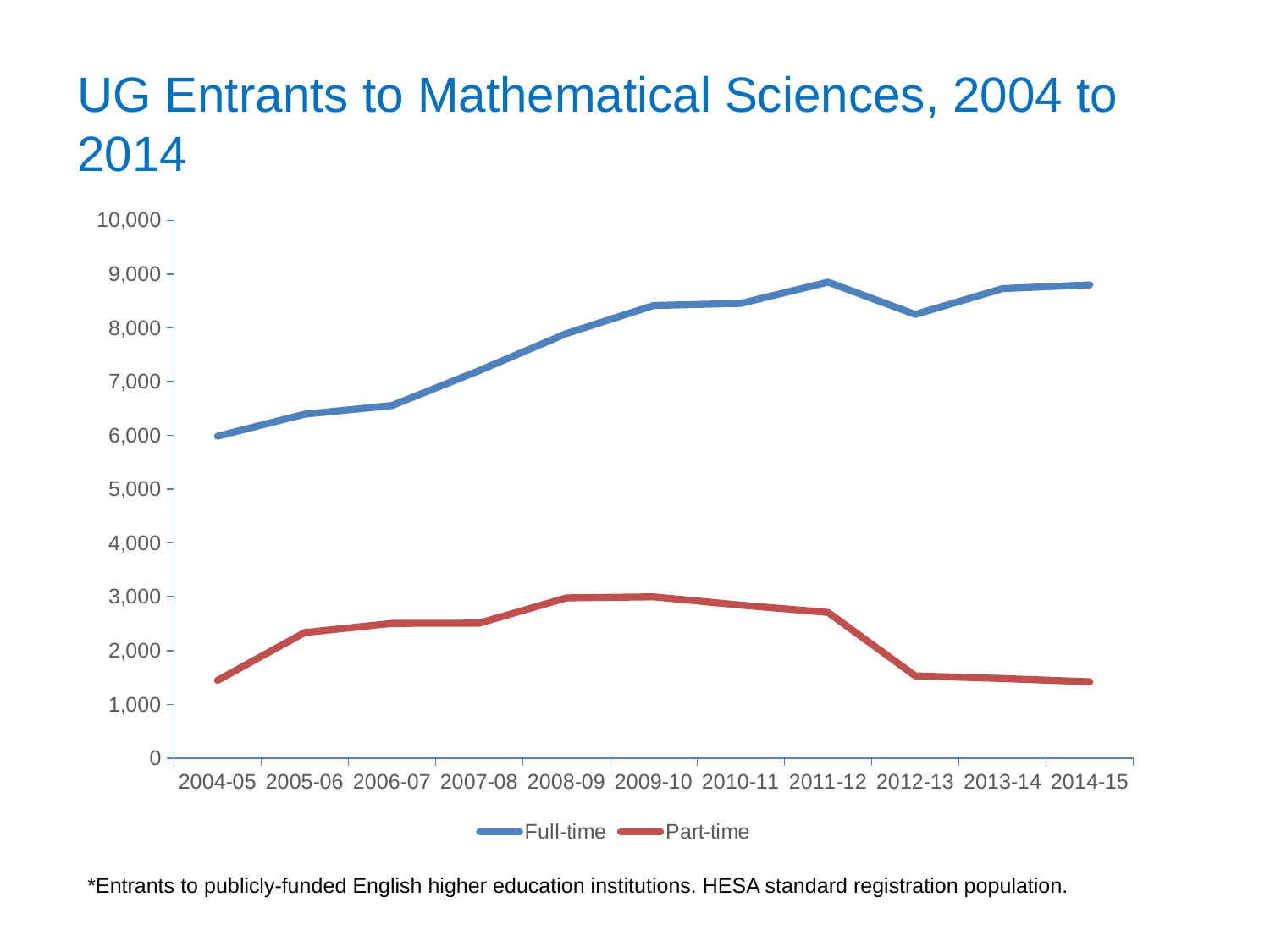
Which is larger, the Part-time value for 2009-10 or for 2012-13? 2009-10 How many academic years are shown on the x axis? 11 What kind of chart is shown on the slide? line chart Which academic year has the lowest Full-time value? 2004-05 Is the Part-time value for 2005-06 greater or less than 2,000? greater Is the Full-time value for 2008-09 greater or less than 7,000? greater Does the Part-time line rise or fall between 2011-12 and 2012-13? fall What colour is the Part-time line? red How many series does the legend list? 2 Is the Full-time value for 2005-06 greater or less than 7,000? less Which is larger, the Full-time value for 2014-15 or for 2004-05? 2014-15